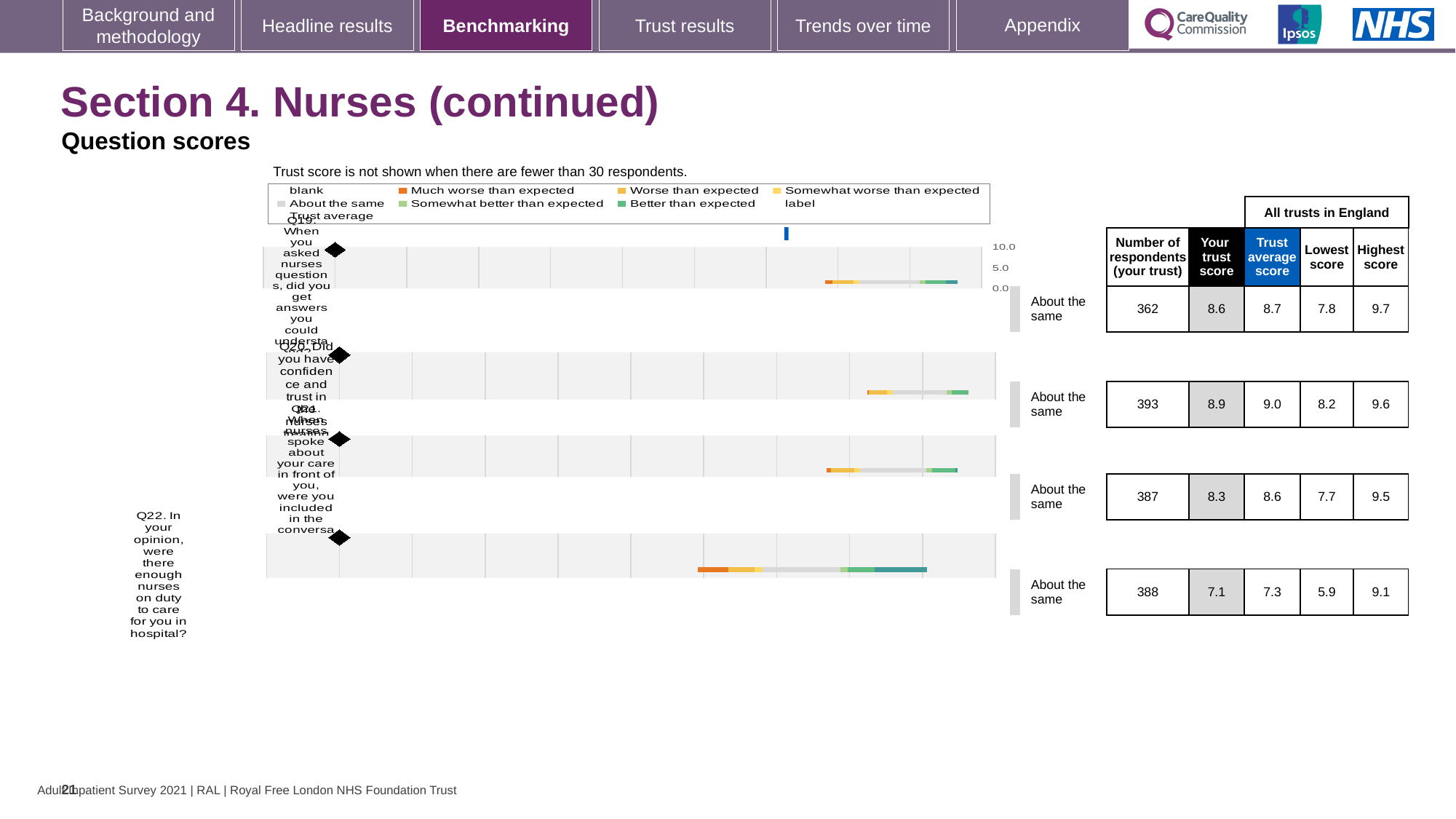
What kind of chart is used to show the question scores on this slide? bar chart What is the 'Your trust score' for Q19 (When you asked nurses questions, did you get answers you could understand)? 8.6 What is the difference between the highest score and the lowest score for Q19? 1.9 What is the number of respondents for Q20 (Did you have confidence and trust in the nurses treating you)? 393 What benchmark category is shown for Q20 next to the chart? About the same How many questions (categories) are plotted in the chart? 4 What is the 'Trust average score' for Q22 (were there enough nurses on duty to care for you in hospital)? 7.3 What is the lowest score across all trusts in England for Q22? 5.9 Which question has the lowest 'Your trust score'? Q22 Is the 'Your trust score' for Q22 greater or less than 5.0? greater Which question has the highest 'Your trust score'? Q20 For Q21, which is larger: 'Your trust score' or 'Trust average score'? Trust average score